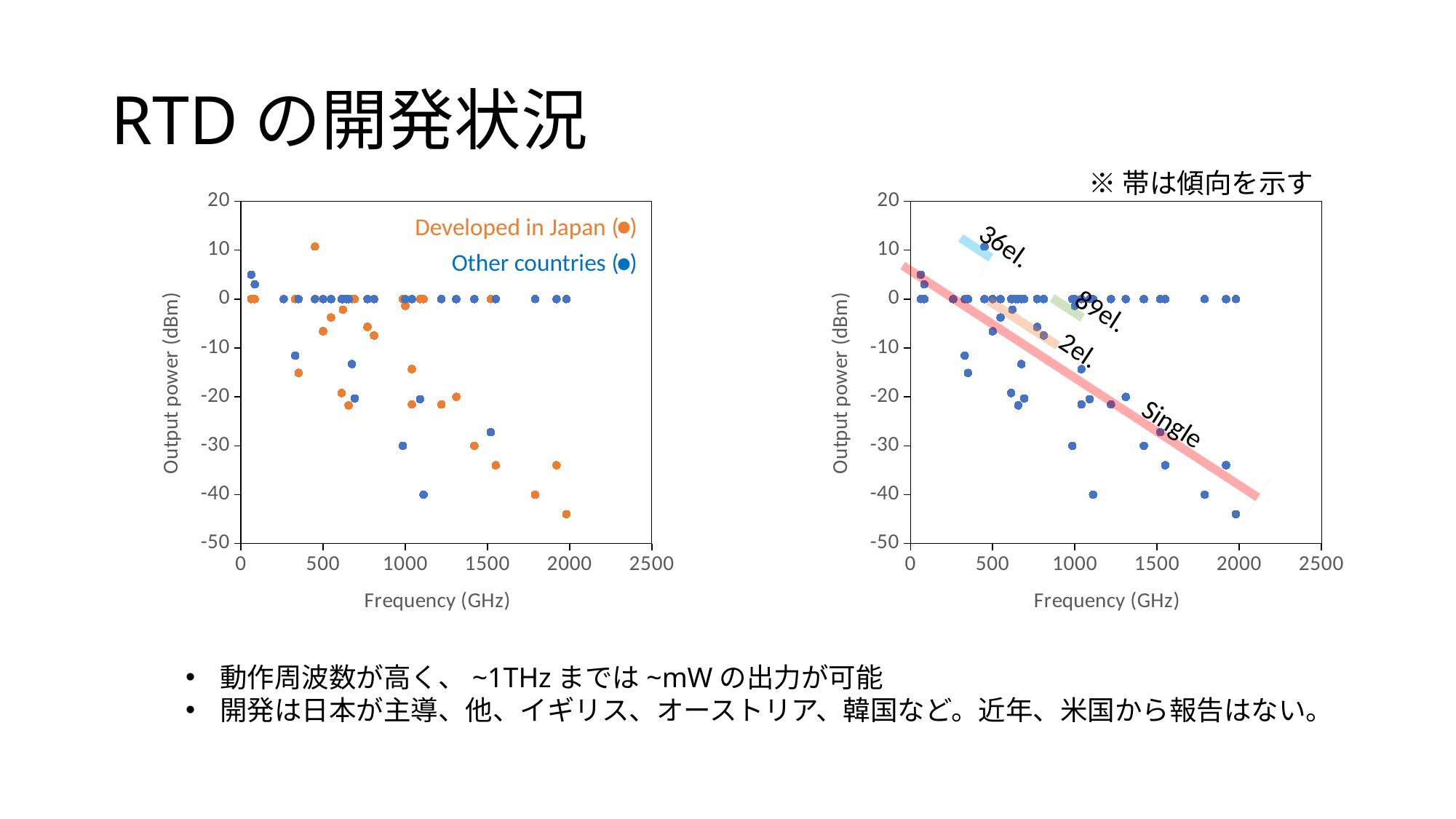
What is the y-axis label of the right chart? Output power (dBm) What is the lowest value shown on the y axis of the left chart? -50 In the left chart, is the lowest orange point near 2000 GHz greater or less than -40 dBm? less How many series does the legend of the left chart list? 2 In the left chart, which colour marks the 'Developed in Japan' series? Orange In the left chart, is the blue point near 1100 GHz at the bottom of the plot greater or less than -30 dBm? less How many labelled trend bands are drawn on the right chart? 4 What is the highest value shown on the x axis of the right chart? 2500 In the right chart, does the 'Single' trend band rise or fall as frequency increases? Fall What kind of chart is the left chart on the slide? Scatter chart